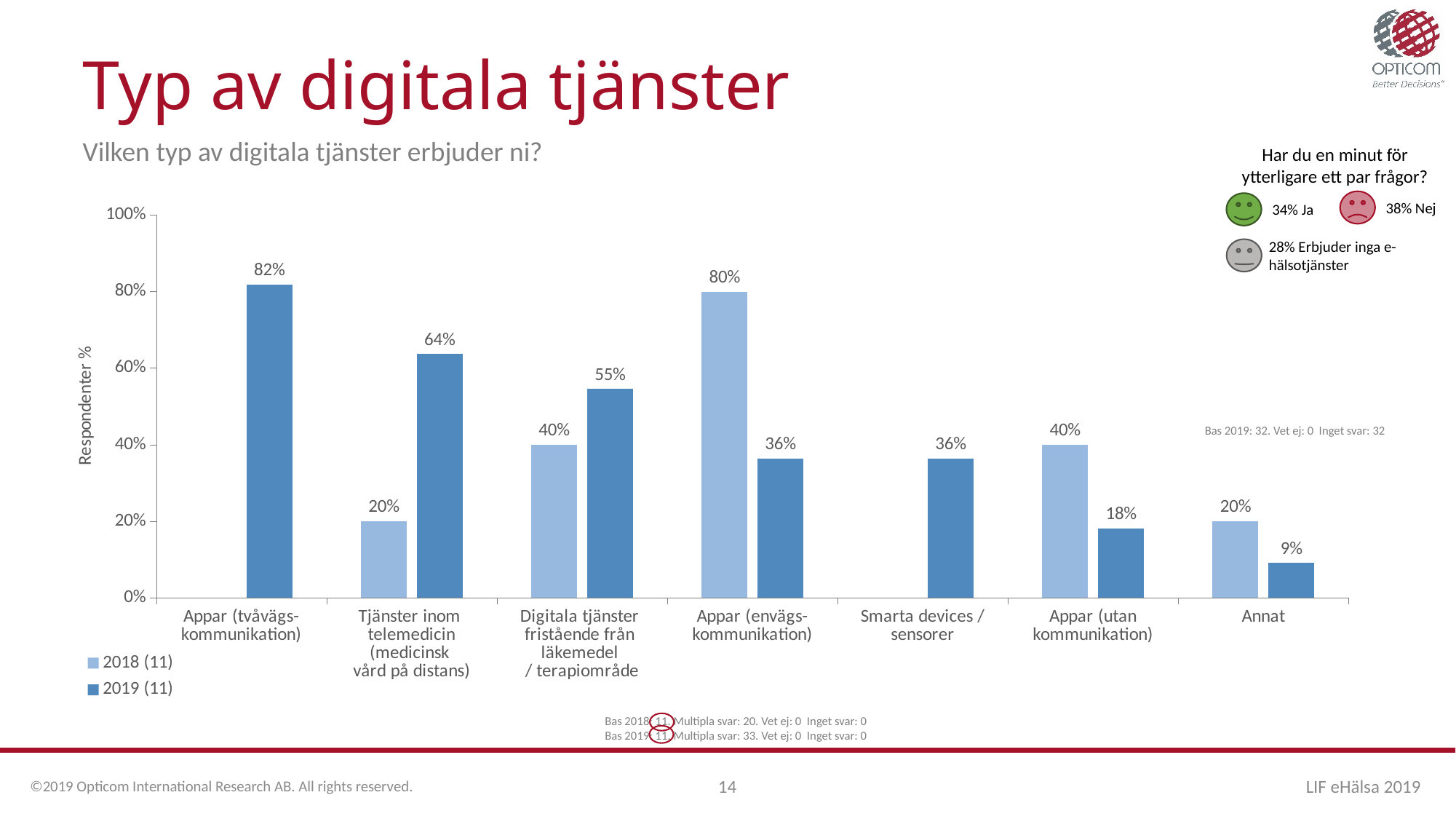
How many categories are shown on the x axis? 7 For Appar (envägs-kommunikation), which year has the larger value, 2018 or 2019? 2018 What is the 2019 value for Annat? 9% What is the difference between the 2019 and 2018 values for Tjänster inom telemedicin (medicinsk vård på distans)? 44 percentage points What is the 2018 value for Appar (envägs-kommunikation)? 80% What is the 2019 value for Tjänster inom telemedicin (medicinsk vård på distans)? 64% What is the 2019 value for Appar (tvåvägs-kommunikation)? 82% What kind of chart is shown on the slide? Bar chart Which category has the lowest 2019 value? Annat How many series does the legend list? 2 Which category has the highest 2019 value? Appar (tvåvägs-kommunikation) What is the label of the y axis? Respondenter %